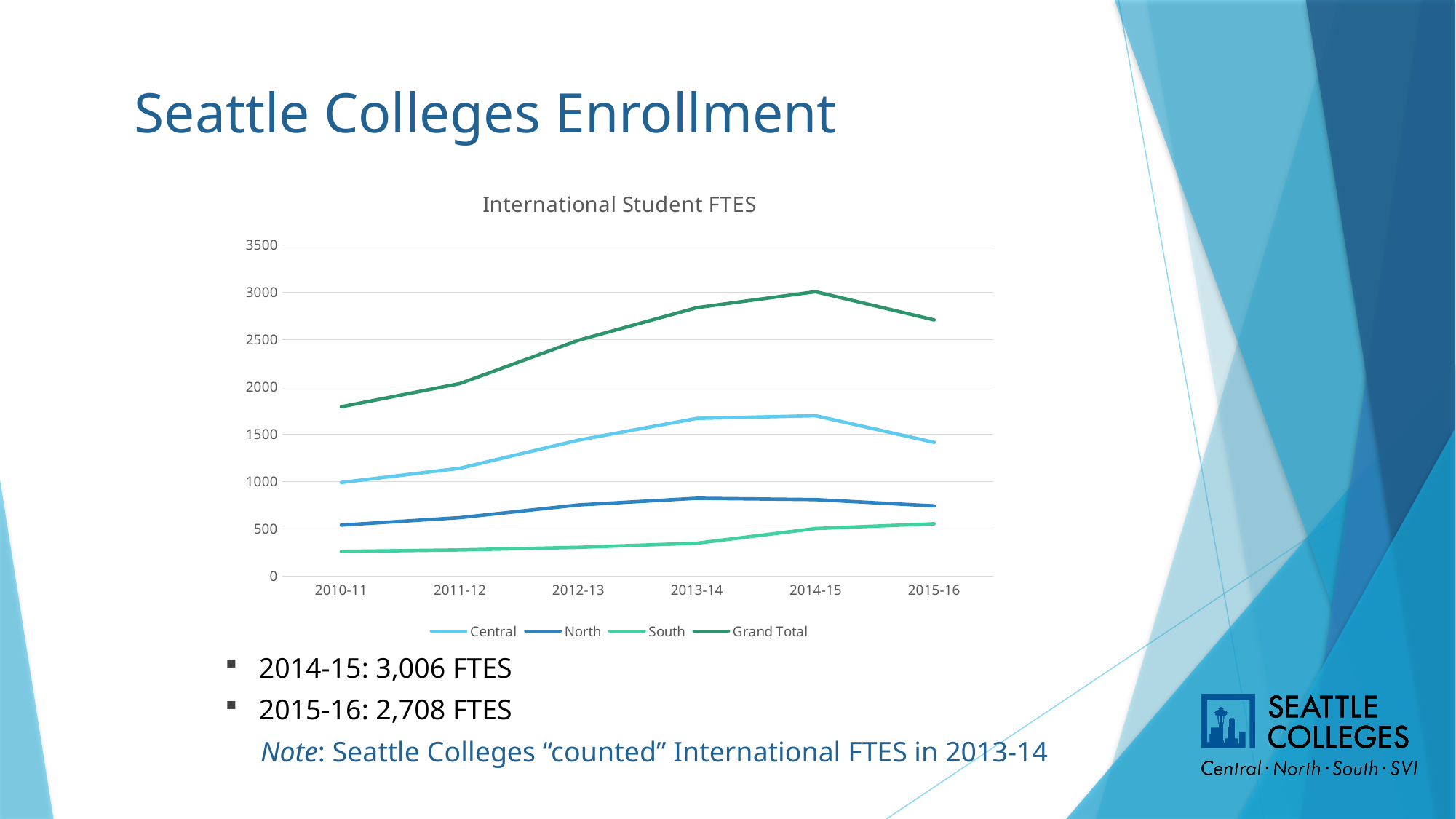
By how much did the Grand Total FTES fall from 2014-15 to 2015-16? 298 How many academic years are plotted along the x axis? 6 Is the value for Central in 2013-14 greater or less than 1500? greater According to the slide, what was the Grand Total of International Student FTES in 2015-16? 2,708 FTES In which year does the Grand Total line reach its highest point? 2014-15 What is the title of the chart? International Student FTES How many series does the chart legend list? 4 Which series has the larger value in 2013-14, Central or North? Central Is the value for South in 2010-11 greater or less than 500? less According to the slide, what was the Grand Total of International Student FTES in 2014-15? 3,006 FTES What kind of chart is shown on the slide? line chart In which year is the Grand Total line at its lowest? 2010-11